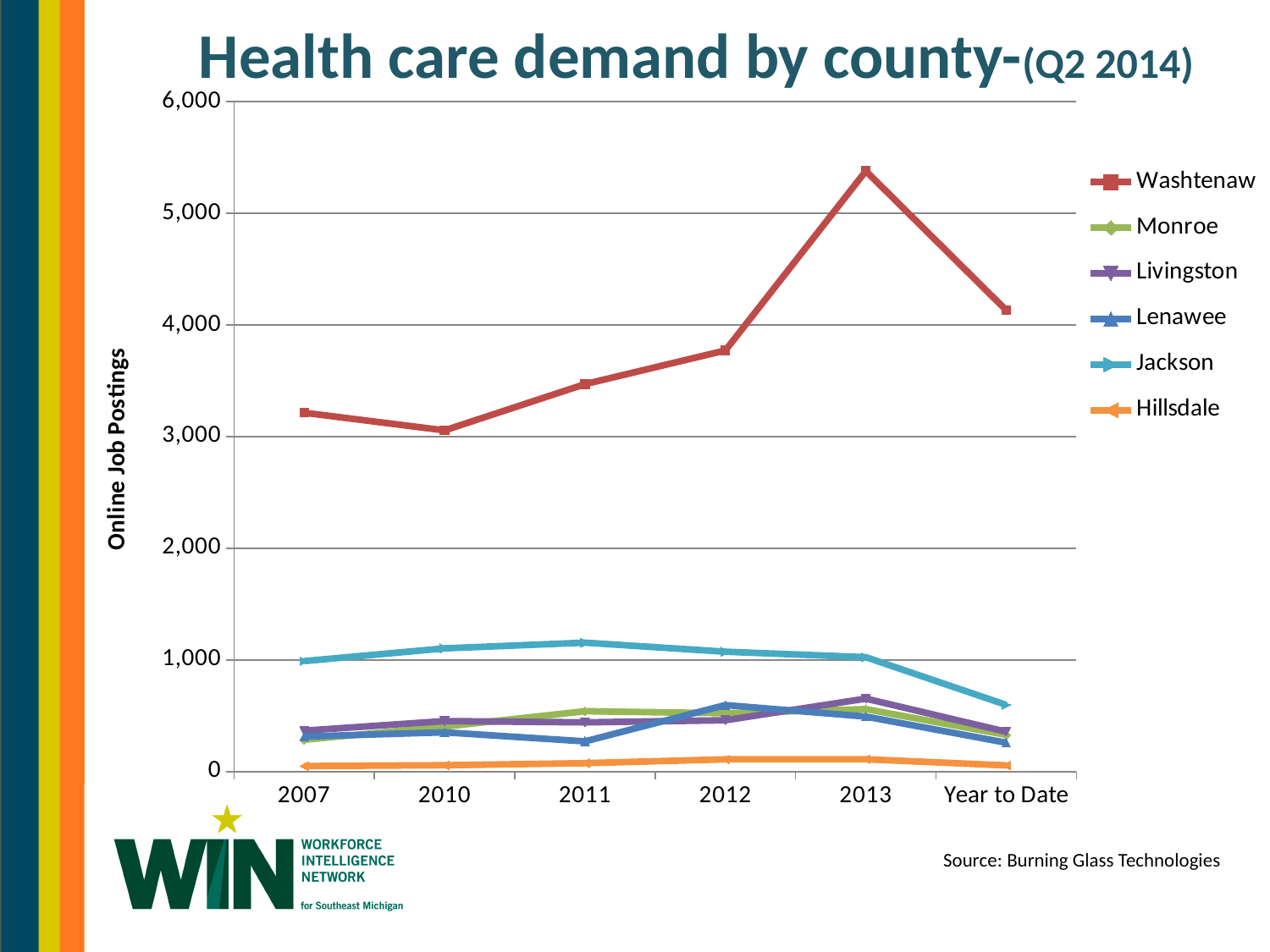
What is the label on the y axis? Online Job Postings In which year does the Washtenaw line reach its peak? 2013 How many time points are shown along the x axis? 6 Is the value for Jackson in Year to Date greater or less than 1,000? less Is the value for Washtenaw in 2012 greater or less than 4,000? less Which county had the highest number of online job postings in 2013? Washtenaw How many counties (series) does the legend list? 6 Which is larger in 2012, the value for Jackson or the value for Monroe? Jackson What kind of chart is shown on the slide? line chart Is the value for Washtenaw in 2013 greater or less than 5,000? greater Do Washtenaw's online job postings rise or fall from 2010 to 2013? rise Which county had the lowest number of online job postings in 2013? Hillsdale